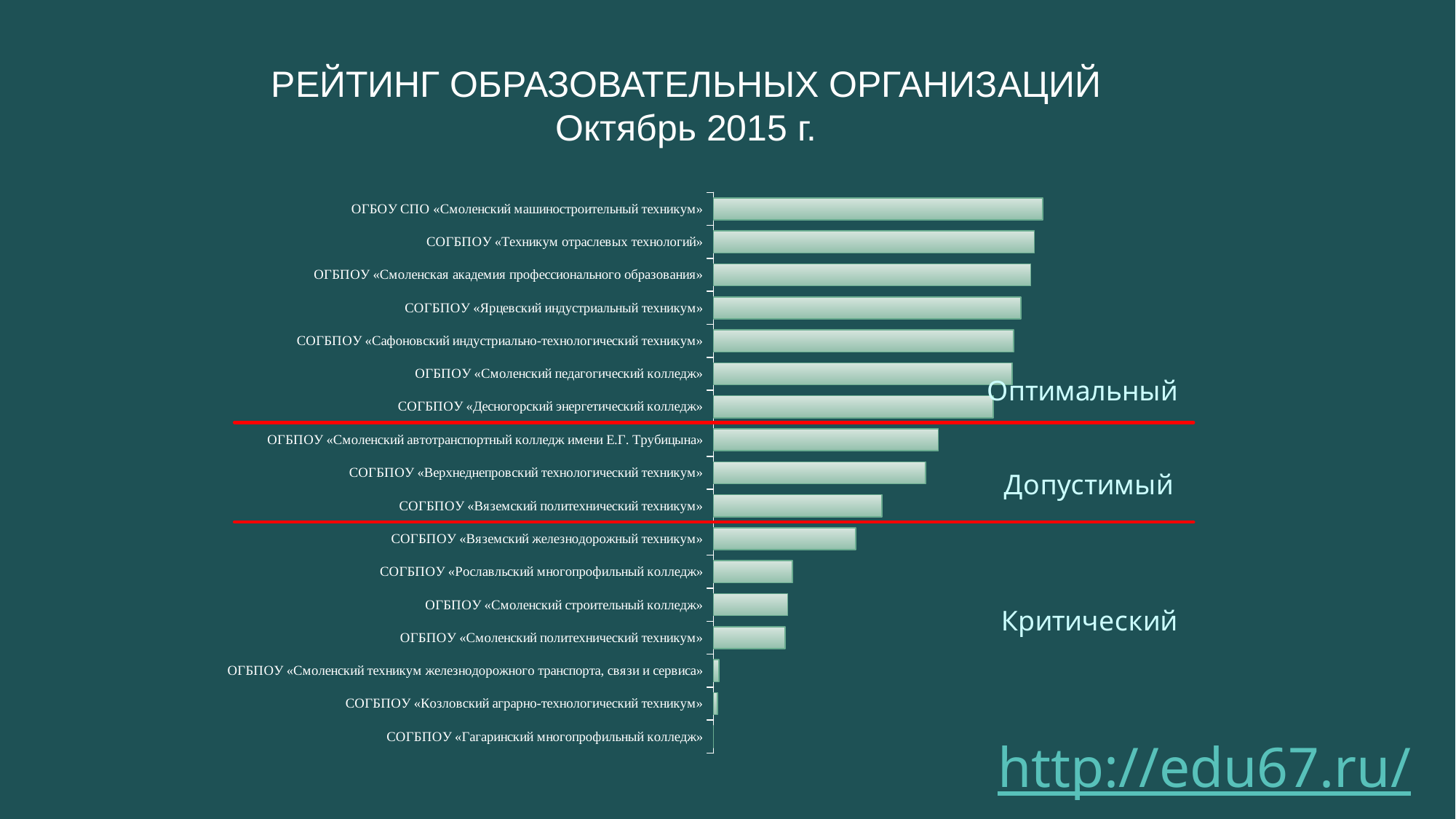
Which has the larger value: СОГБПОУ «Техникум отраслевых технологий» or СОГБПОУ «Верхнеднепровский технологический техникум»? СОГБПОУ «Техникум отраслевых технологий» How many educational organizations are listed in the chart? 17 Which has the larger value: СОГБПОУ «Вяземский политехнический техникум» or СОГБПОУ «Вяземский железнодорожный техникум»? СОГБПОУ «Вяземский политехнический техникум» Which organization has the lowest rating in the chart? СОГБПОУ «Гагаринский многопрофильный колледж» What is the title of the chart on the slide? РЕЙТИНГ ОБРАЗОВАТЕЛЬНЫХ ОРГАНИЗАЦИЙ Октябрь 2015 г. What kind of chart is shown on the slide? bar chart Do the bar values rise or fall going from the top of the chart to the bottom? fall What are the three rating zones labelled on the right side of the chart? Оптимальный, Допустимый, Критический Which has the larger value: ОГБПОУ «Смоленский автотранспортный колледж имени Е.Г. Трубицына» or СОГБПОУ «Рославльский многопрофильный колледж»? ОГБПОУ «Смоленский автотранспортный колледж имени Е.Г. Трубицына» Which organization has the highest rating in the chart? ОГБОУ СПО «Смоленский машиностроительный техникум»